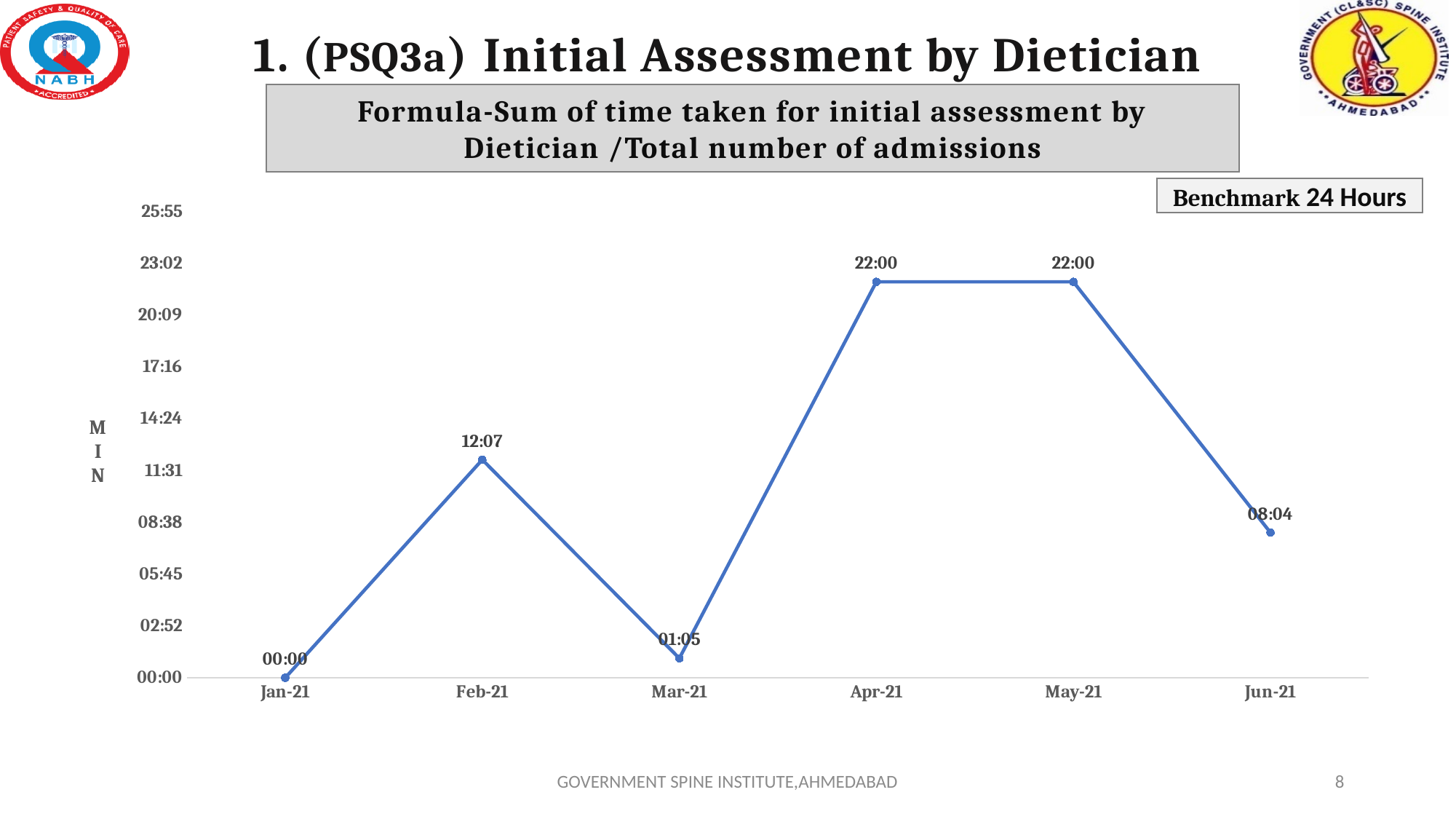
Which months share the highest value? Apr-21 and May-21 What is the value for Jun-21? 08:04 What is the value for Apr-21? 22:00 What kind of chart is shown? Line chart Which is larger, the value for Feb-21 or the value for Jun-21? Feb-21 What is the difference between the values for Feb-21 and Mar-21? 11:02 What benchmark is stated on the slide? 24 Hours Does the value rise or fall from May-21 to Jun-21? Fall How many months are plotted on the chart? 6 Which month has the lowest value? Jan-21 What is the value for Mar-21? 01:05 What is the value for Feb-21? 12:07